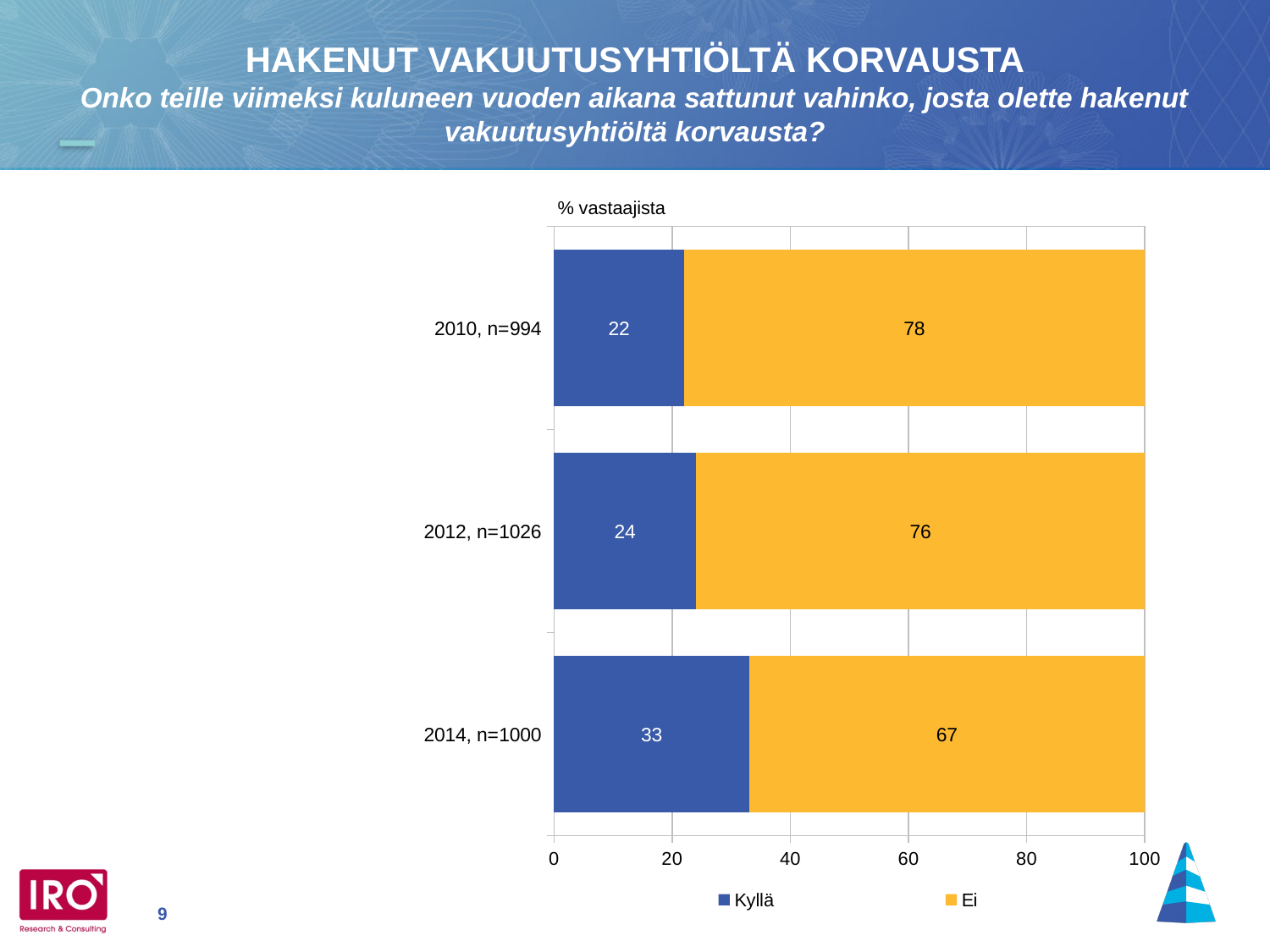
What is the Kyllä value for 2012, n=1026? 24 What kind of chart is shown on the slide? Stacked bar chart What is the axis label shown above the chart? % vastaajista How many series does the legend list? 2 How many categories are shown on the chart? 3 Which category has the lowest Ei value? 2014, n=1000 What is the Ei value for 2010, n=994? 78 What is the difference between the Kyllä values for 2014, n=1000 and 2010, n=994? 11 Which is larger, the Ei value for 2010, n=994 or the Ei value for 2012, n=1026? 2010, n=994 Which category has the highest Kyllä value? 2014, n=1000 What is the Kyllä value for 2014, n=1000? 33 What is the total of the stacked bar for 2012, n=1026? 100